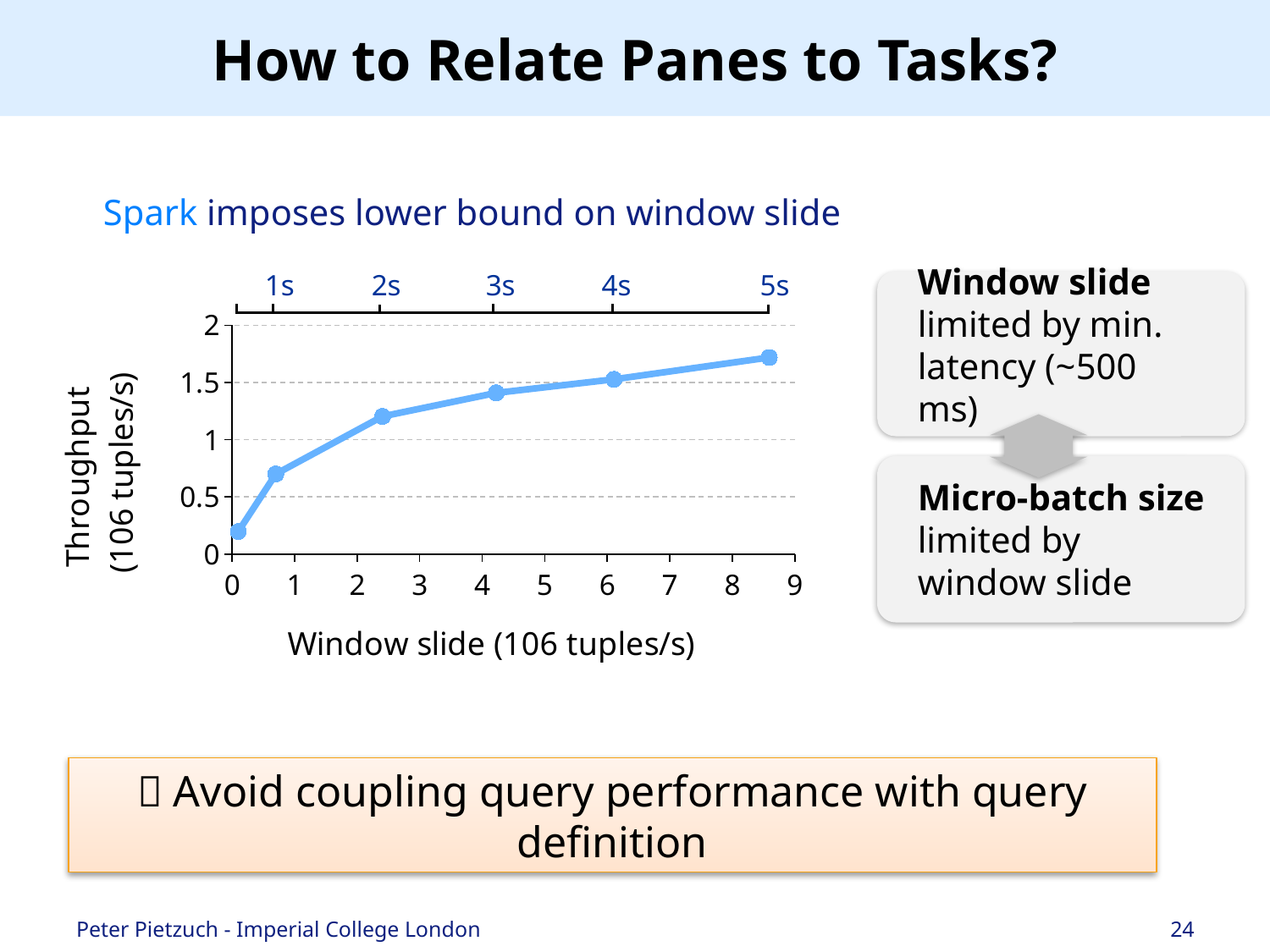
Which data point has the lowest throughput, the leftmost or the rightmost? the leftmost Is the throughput of the second data point from the left greater or less than 0.5? greater What kind of chart is shown on the slide? line chart Is the throughput of the leftmost data point greater or less than 0.5? less What is the label of the y axis of the chart? Throughput (106 tuples/s) Is the throughput of the rightmost data point greater or less than 1.5? greater Which data point has the higher throughput, the leftmost or the rightmost? the rightmost How many data points are plotted on the line? 6 What is the label of the x axis of the chart? Window slide (106 tuples/s) Does throughput rise or fall as window slide increases along the x axis? rise